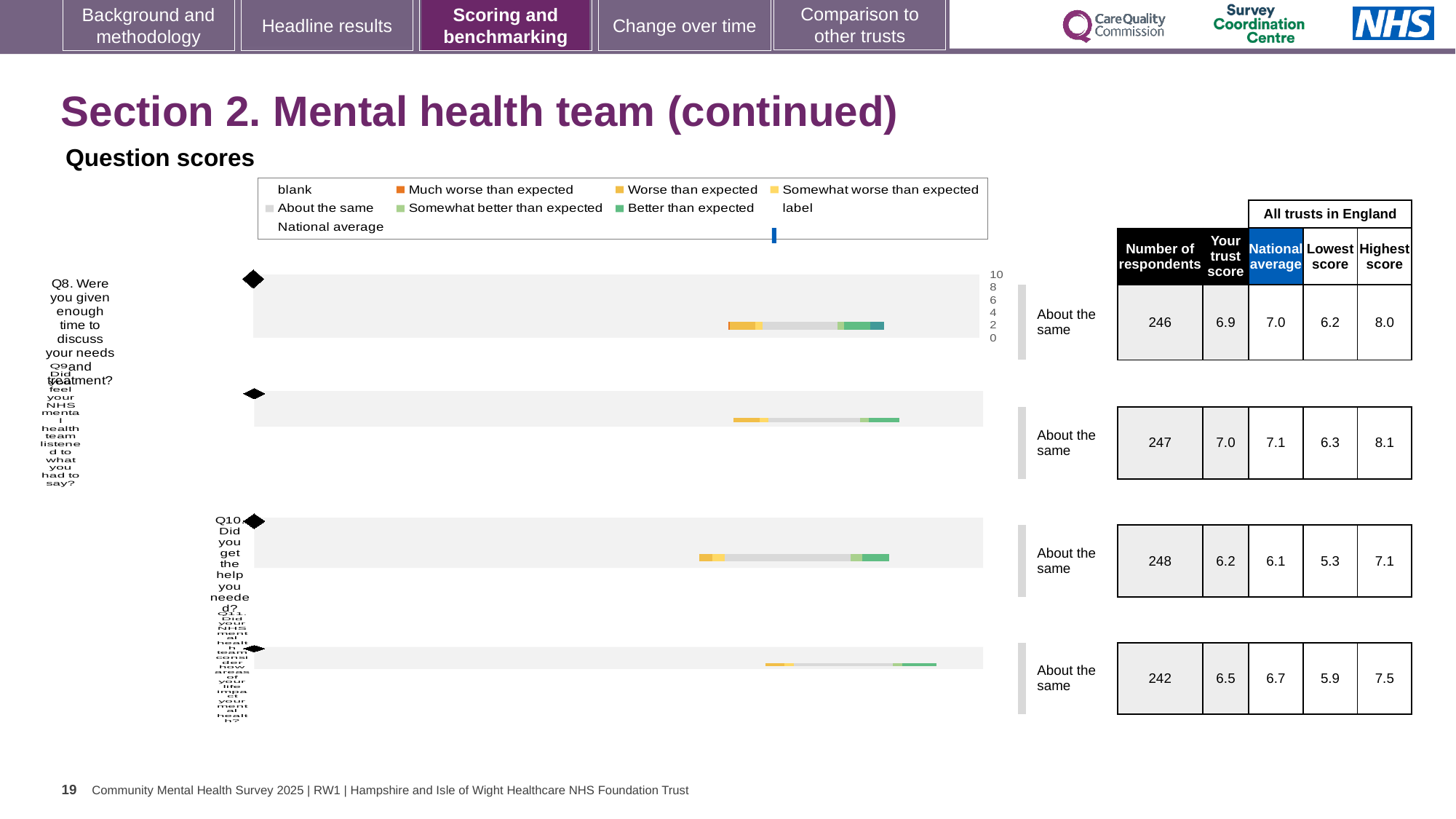
For Q10, how much higher is the trust score than the national average? 0.1 Which question has the highest trust score on this slide? Q9 What kind of chart is used to show the question scores? Bar chart What is the trust score for Q8 (Were you given enough time to discuss your needs and treatment?)? 6.9 For Q8, what is the difference between the highest score and the lowest score across all trusts in England? 1.8 For Q11, which is larger: the trust score or the national average? National average How many questions are charted on this slide? 4 What colour represents 'Much worse than expected' in the legend? Orange What is the national average score for Q10 (Did you get the help you needed?)? 6.1 How many respondents answered Q9? 247 What benchmark category is shown for Q8? About the same Which question has the lowest trust score on this slide? Q10